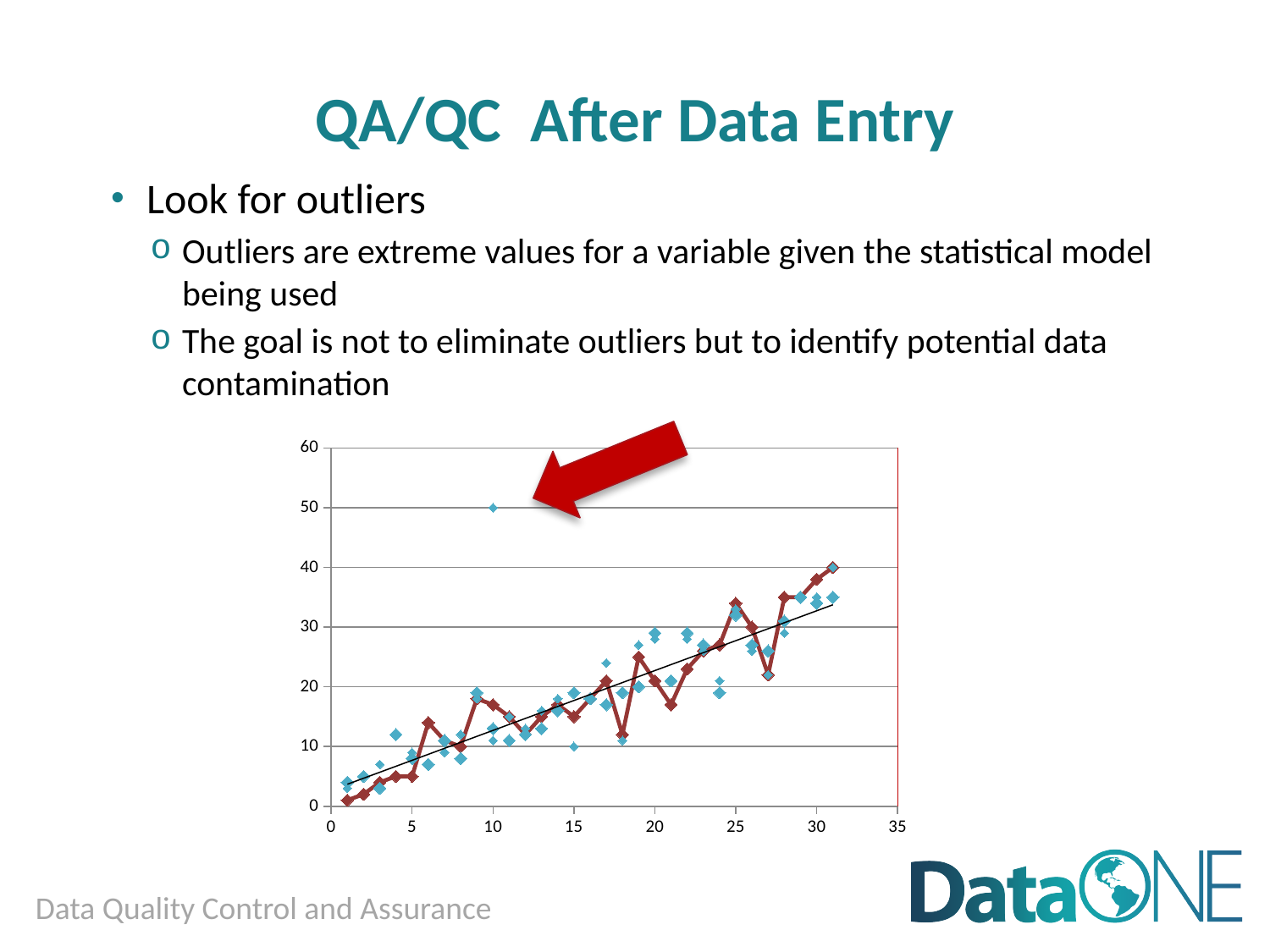
Is the value of the point at x = 20 greater or less than 10? greater What does the large red arrow on the chart point to? the outlier point What is the highest value shown on the y axis? 60 What kind of chart is shown on the slide? scatter chart Is the value of the outlier point near x = 10 greater or less than 40? greater Is the value of the point at x = 5 greater or less than 20? less At which x value does the highest plotted point (the outlier) occur? 10 Do the plotted values generally rise or fall as the x value increases? rise